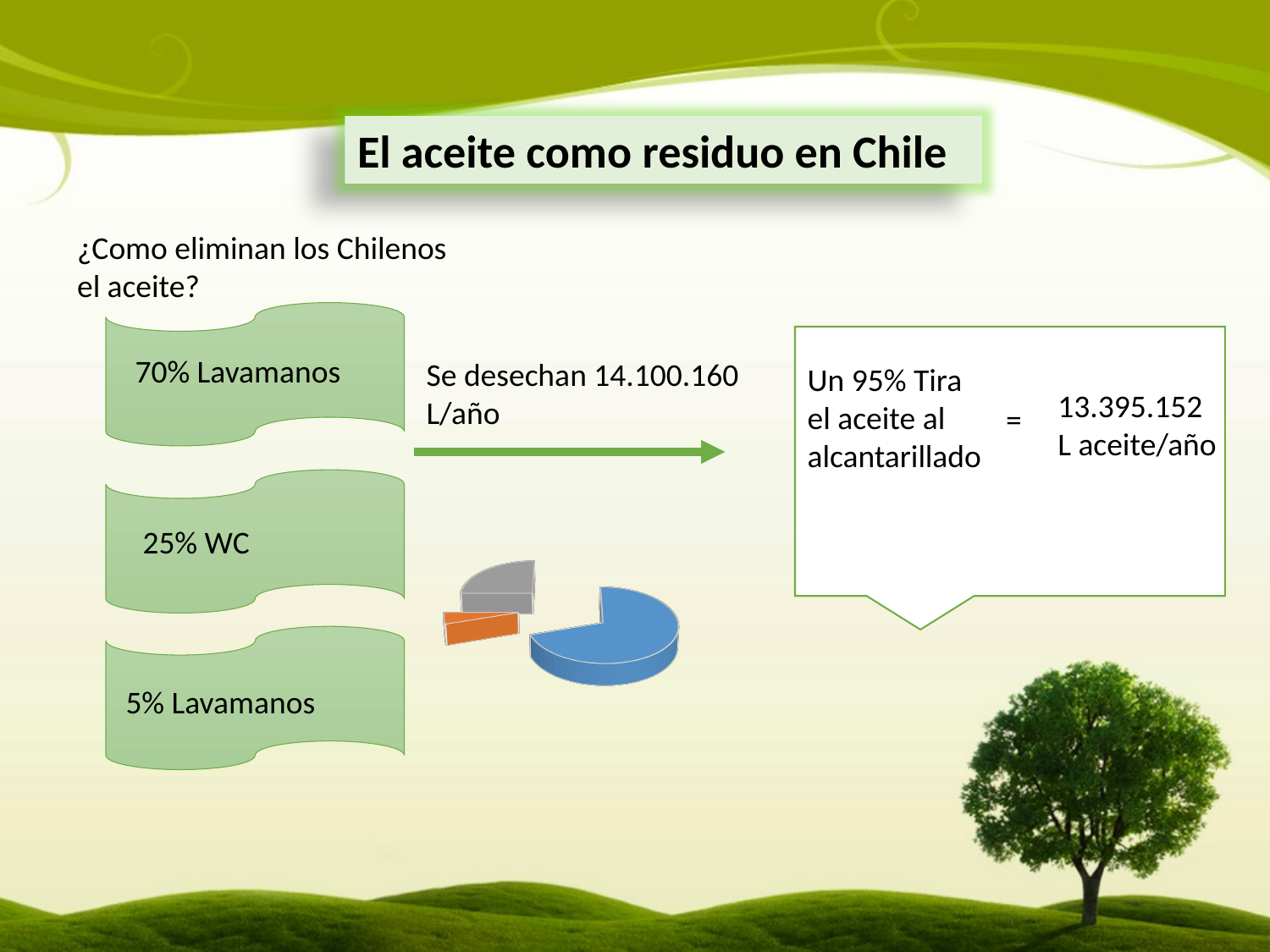
Which colour slice is the smallest in the pie chart? orange Does the pie chart display a legend? No In the pie chart, which is larger, the blue slice or the gray slice? blue How many slices does the pie chart have? 3 What kind of chart is shown on the slide? pie chart In the pie chart, which is larger, the gray slice or the orange slice? gray Which colour slice is the largest in the pie chart? blue Is the blue slice of the pie chart more or less than half of the pie? more